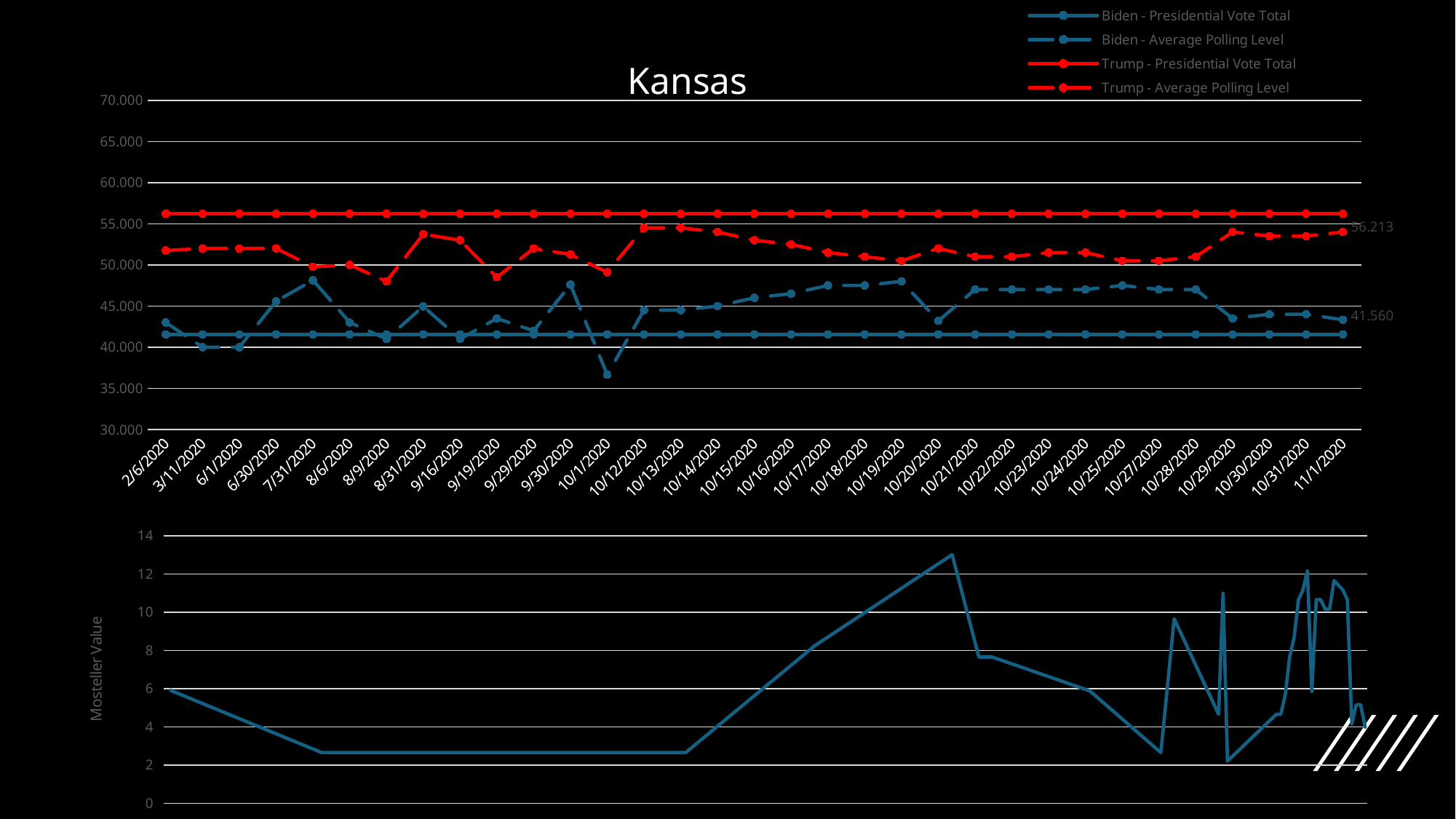
In the top chart titled Kansas, what is the difference between the labelled Trump - Presidential Vote Total (56.213) and the labelled Biden - Presidential Vote Total (41.560)? 14.653 In the top chart titled Kansas, what value is labelled at the end of the Biden - Presidential Vote Total line? 41.560 In the top chart titled Kansas, how many dates are shown on the x axis? 33 In the bottom chart, what is the label on the vertical axis? Mosteller Value In the top chart titled Kansas, what kind of chart is it? line chart In the top chart titled Kansas, what value is labelled at the end of the Trump - Presidential Vote Total line? 56.213 In the top chart titled Kansas, is the Biden - Average Polling Level value on 10/1/2020 greater or less than 40.000? less In the bottom chart, is the highest point of the line greater or less than 12? greater In the top chart titled Kansas, is the Trump - Average Polling Level value on 8/31/2020 greater or less than 50.000? greater In the top chart titled Kansas, which is larger, the Trump - Presidential Vote Total or the Biden - Presidential Vote Total? Trump - Presidential Vote Total What is the title of the top chart? Kansas In the top chart titled Kansas, how many series does the legend list? 4